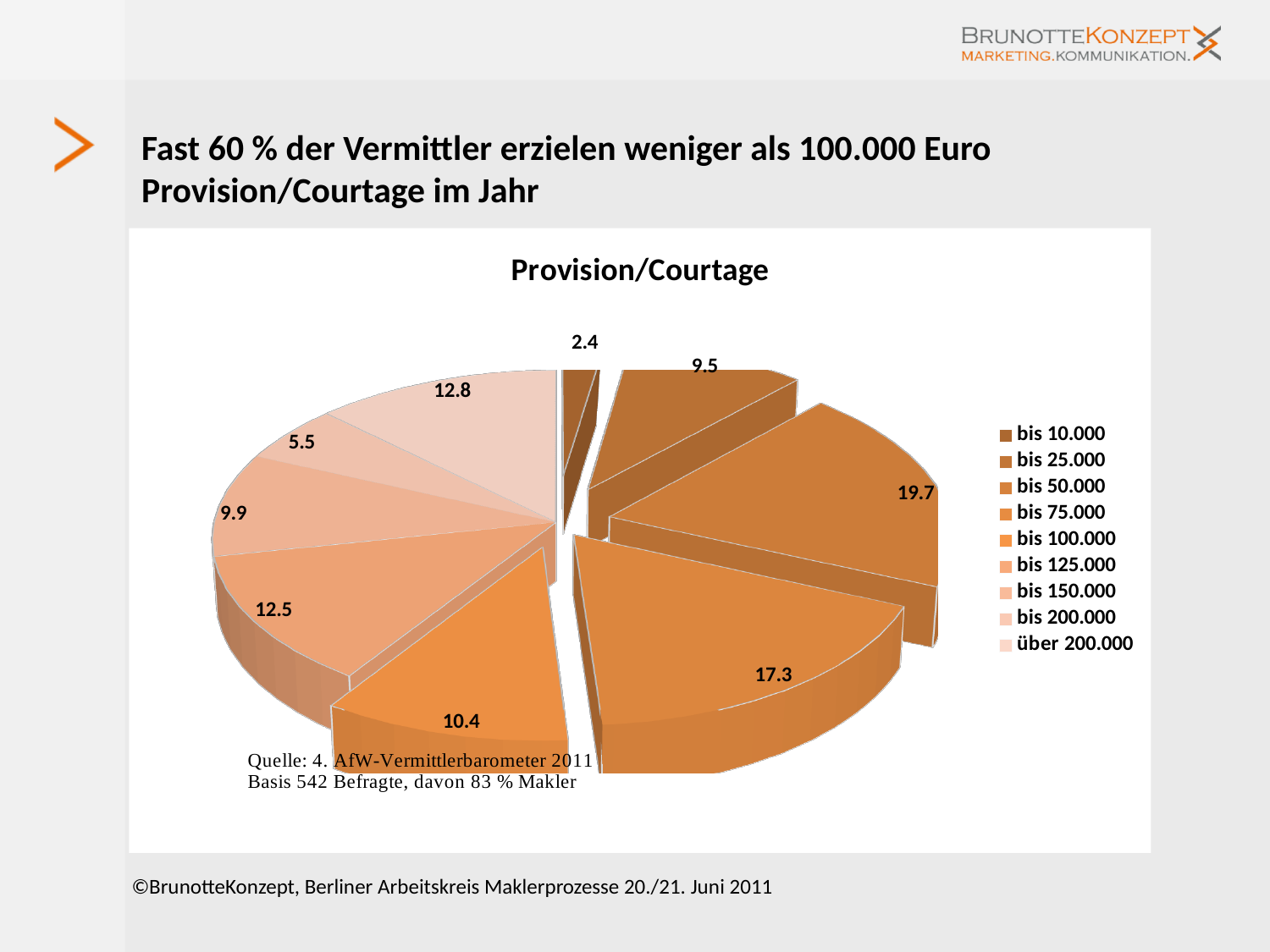
What is the value for the 'über 200.000' slice? 12.8 What is the last entry listed in the legend? über 200.000 What is the value for the 'bis 100.000' slice? 10.4 What is the value for the 'bis 50.000' slice? 19.7 What is the difference between the values for 'bis 50.000' and 'bis 75.000'? 2.4 How many slices does the pie chart have? 9 Which category has the smallest slice? bis 10.000 What is the value for the 'bis 10.000' slice? 2.4 Which category has the largest slice? bis 50.000 Which is larger, the value for 'bis 125.000' or the value for 'bis 150.000'? bis 125.000 What kind of chart is shown on the slide? pie chart What is the title of the chart? Provision/Courtage